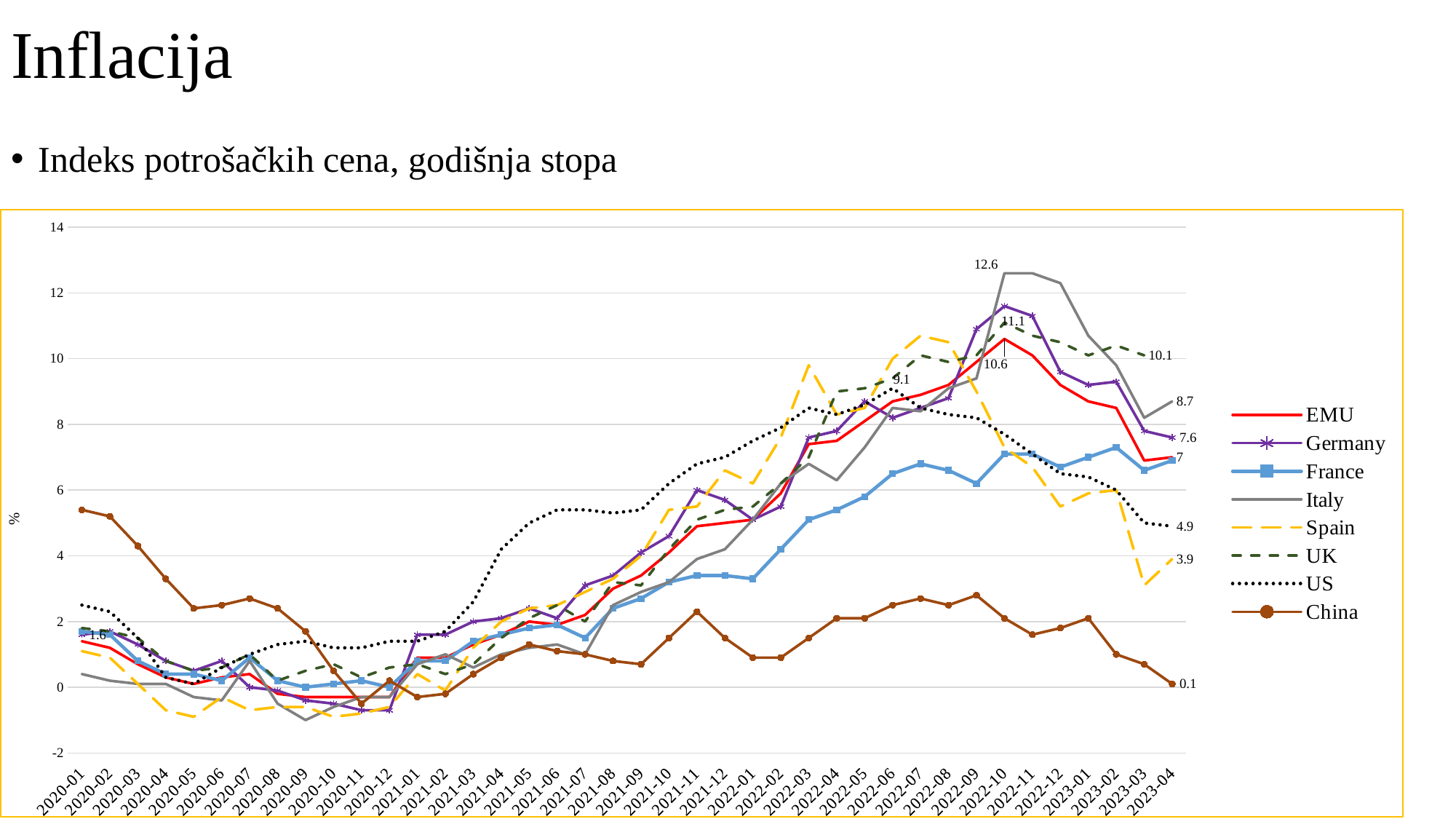
What is the value labelled for Germany at 2023-04? 7.6 Which series has the lowest value at 2023-04? China What is the value labelled for China at 2023-04? 0.1 What is the peak value labelled for Italy in 2022-10? 12.6 Which series has the highest value at 2022-10? Italy What is the value labelled for the US at the end of the series (2023-04)? 4.9 How many series does the legend list? 8 Is the value for China at 2020-01 greater or less than 4? greater What kind of chart is shown on the slide? line chart At 2023-04, which is larger: the value for Germany or the value for the US? Germany What is the difference between the labelled 2022-10 values for Italy (12.6) and EMU (10.6)? 2 How many monthly points are shown on the x axis? 40